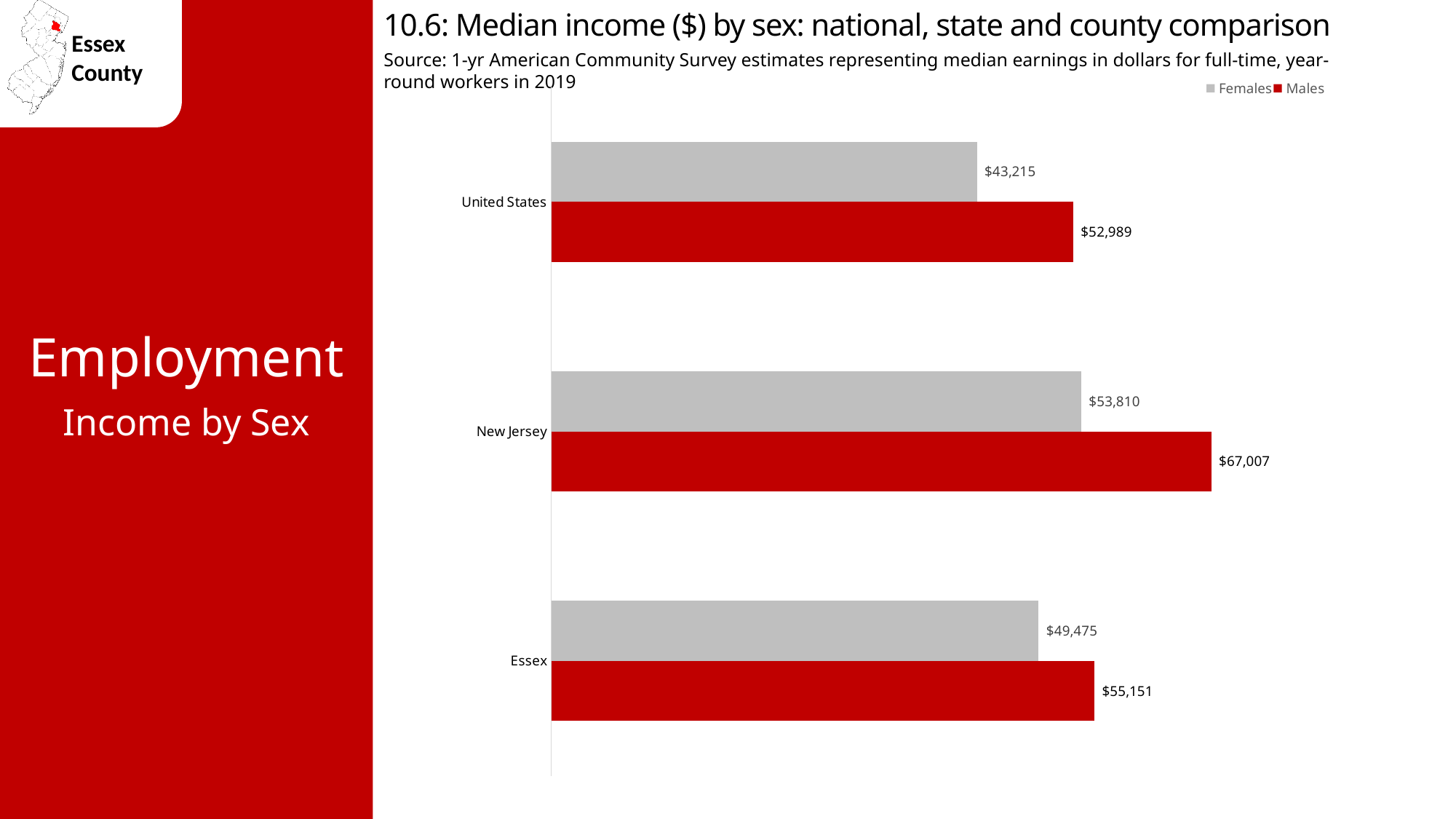
What is the difference between the Males and Females median income in Essex? $5,676 What is the median income for Males in New Jersey? $67,007 How many categories (geographic areas) are shown in the chart? 3 What is the median income for Males in Essex? $55,151 What is the median income for Females in the United States? $43,215 Which category has the highest median income for Males? New Jersey What kind of chart is shown on the slide? Bar chart Which is larger: the Females median income in New Jersey or the Males median income in the United States? Females median income in New Jersey What is the difference between the Males and Females median income in New Jersey? $13,197 Which category has the lowest median income for Females? United States What is the median income for Females in Essex? $49,475 How many series does the legend list? 2